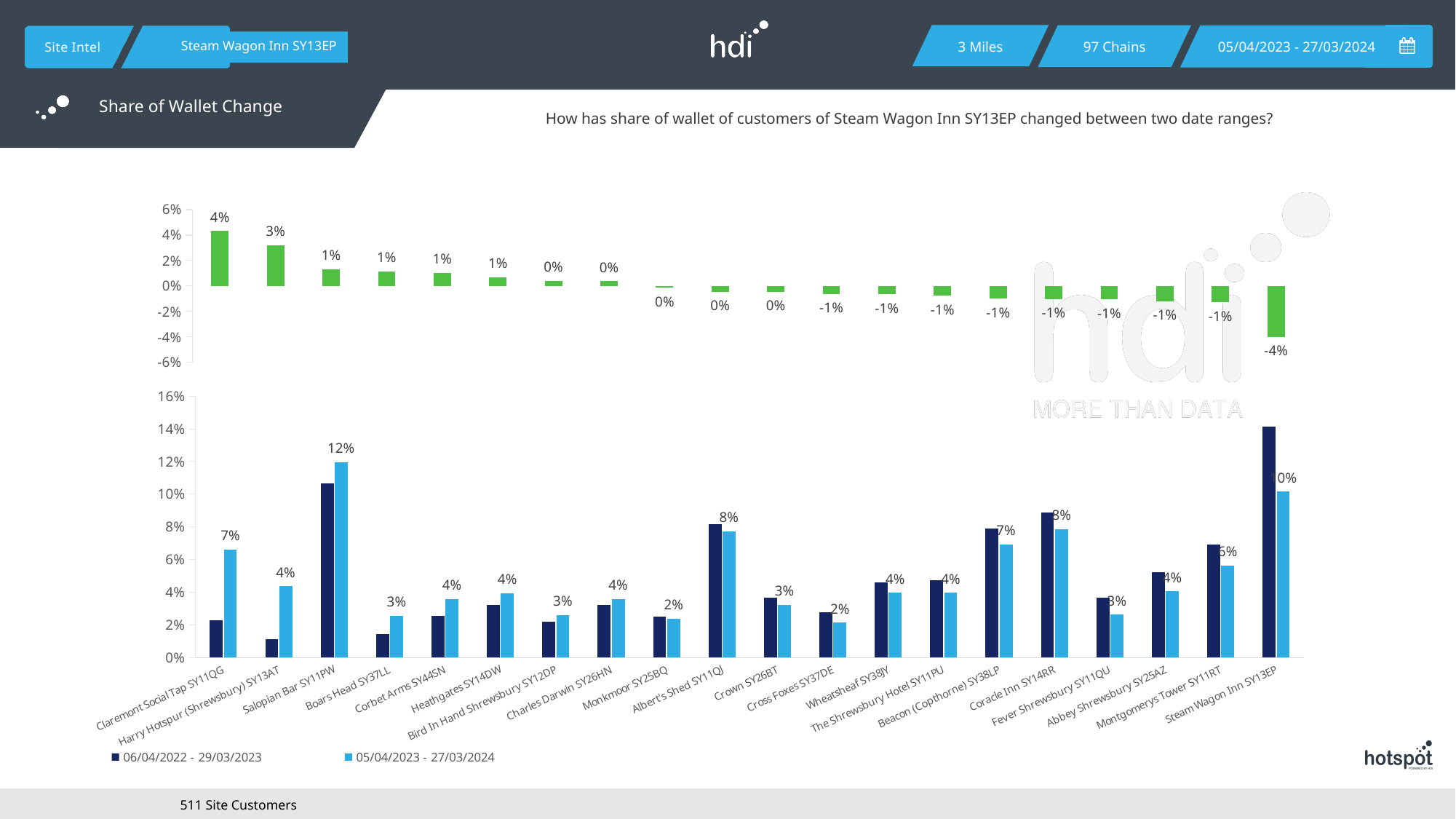
In the top chart (share of wallet change), what is the value for Steam Wagon Inn SY13EP? -4% In the bottom chart, what is the value for Salopian Bar SY11PW in the 05/04/2023 - 27/03/2024 series? 12% In the top chart (share of wallet change), what is the value for Claremont Social Tap SY11QG? 4% In the top chart (share of wallet change), which category has the highest value? Claremont Social Tap SY11QG In the top chart (share of wallet change), which category has the lowest value? Steam Wagon Inn SY13EP How many series does the legend of the bottom chart list? 2 In the bottom chart, which category has the highest value in the 05/04/2023 - 27/03/2024 series? Salopian Bar SY11PW In the bottom chart, is the value for Steam Wagon Inn SY13EP in the 06/04/2022 - 29/03/2023 series greater or less than 12%? greater In the bottom chart, which is larger for Claremont Social Tap SY11QG: the 06/04/2022 - 29/03/2023 value or the 05/04/2023 - 27/03/2024 value? 05/04/2023 - 27/03/2024 In the top chart (share of wallet change), what is the difference between the values for Claremont Social Tap SY11QG and Harry Hotspur (Shrewsbury) SY13AT? 1% What kind of chart is the bottom chart? Bar chart In the bottom chart, what is the value for Steam Wagon Inn SY13EP in the 05/04/2023 - 27/03/2024 series? 10%